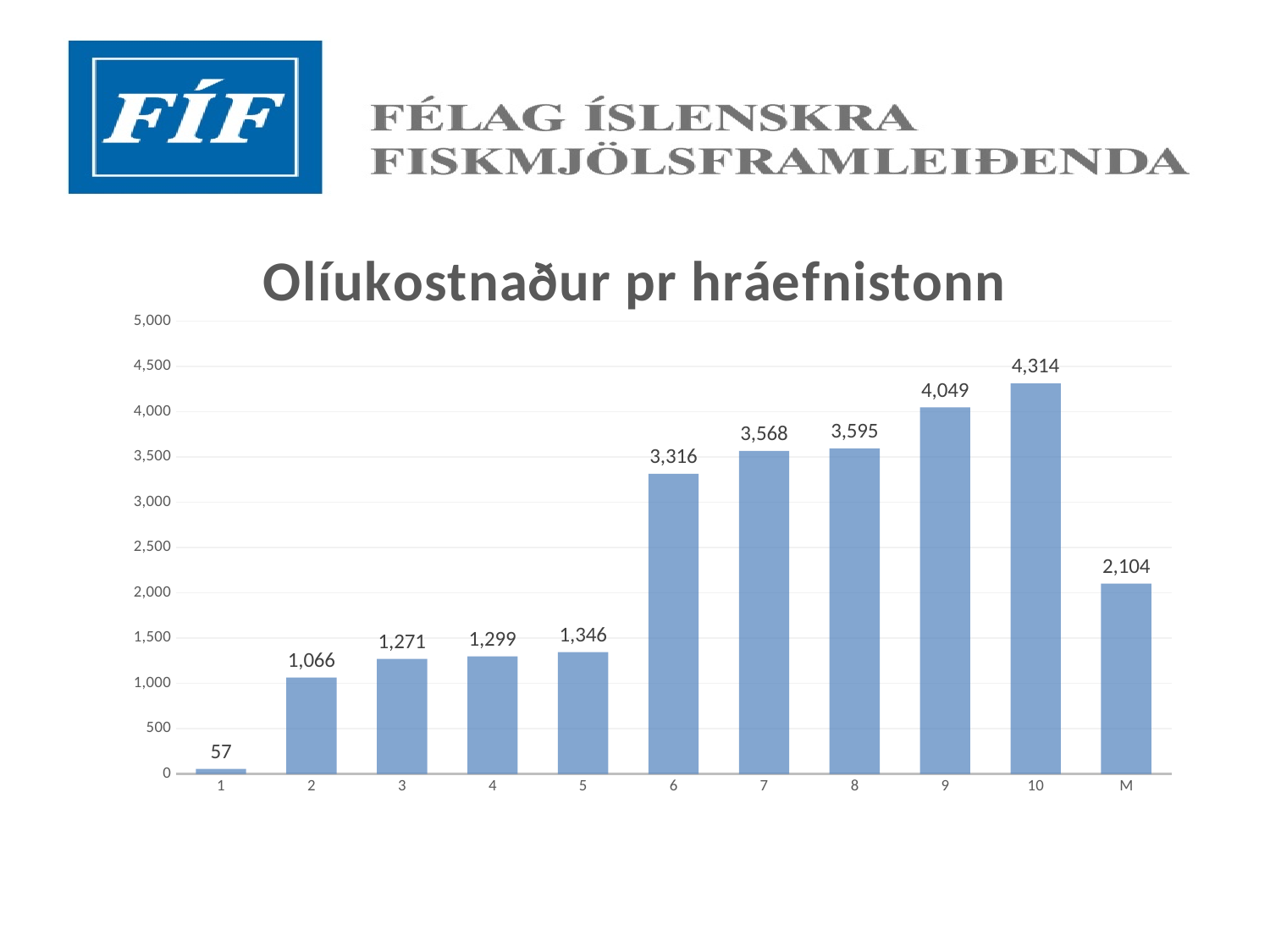
Which category has the highest value? 10 What is the value for category 6? 3,316 What is the difference between the values for category 2 and category 1? 1,009 What is the value for category 1? 57 Which category has the lowest value? 1 What is the value for category M? 2,104 What is the difference between the values for category 10 and category 9? 265 How many categories are shown on the x axis? 11 What kind of chart is shown on the slide? bar chart Which is larger, the value for category 5 or the value for category 6? 6 Is the value for category 8 greater or less than 3,500? greater What is the title of the chart? Olíukostnaður pr hráefnistonn